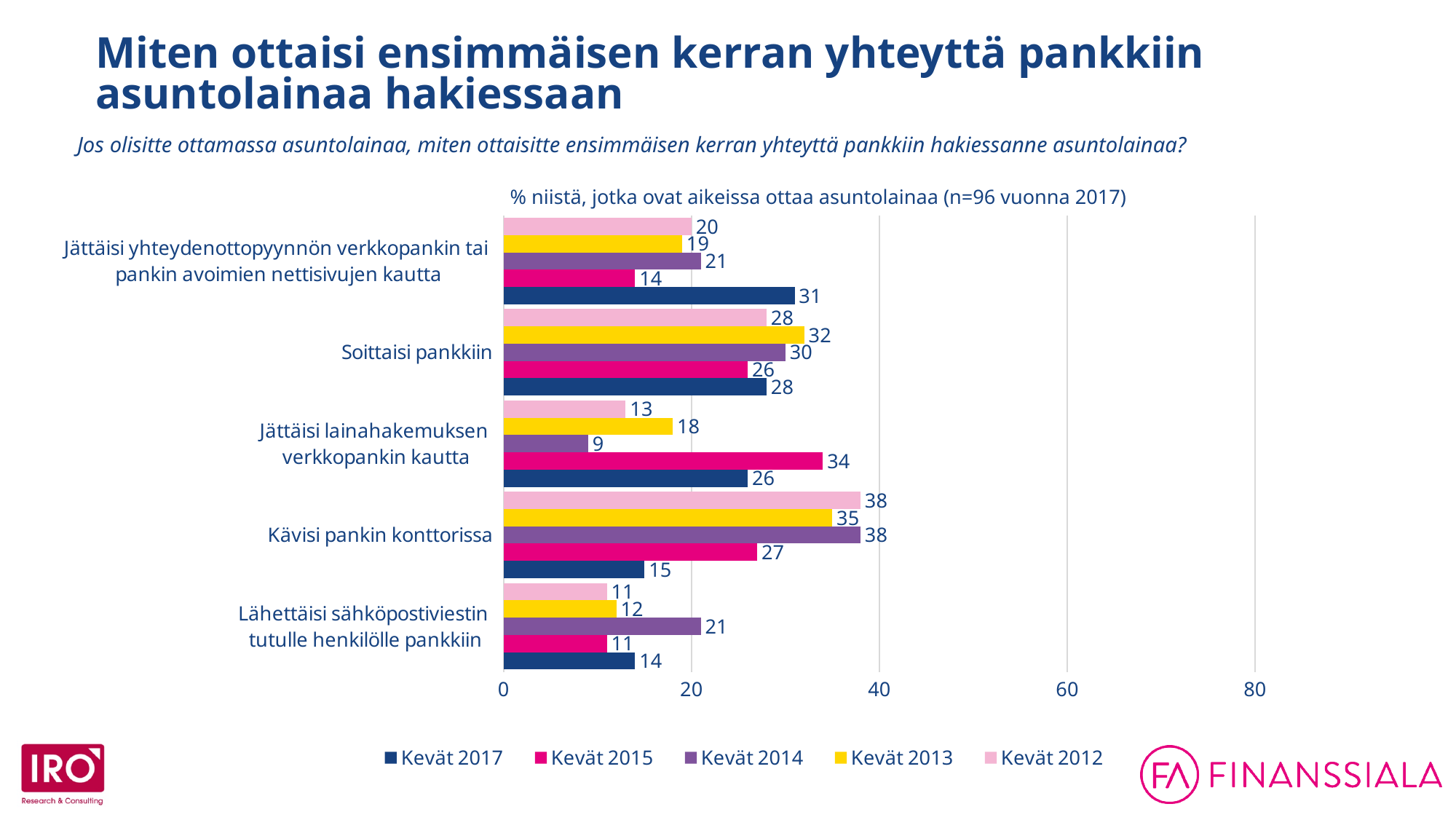
Which category has the lowest value for Kevät 2014? Jättäisi lainahakemuksen verkkopankin kautta Which category has the highest value for Kevät 2017? Jättäisi yhteydenottopyynnön verkkopankin tai pankin avoimien nettisivujen kautta What is the difference between the Kevät 2012 and Kevät 2017 values for 'Kävisi pankin konttorissa'? 23 How many series does the legend list? 5 Which series is shown in dark blue in the legend? Kevät 2017 Which is larger in the category 'Lähettäisi sähköpostiviestin tutulle henkilölle pankkiin': the Kevät 2014 value or the Kevät 2017 value? Kevät 2014 What is the value for Kevät 2013 in the category 'Soittaisi pankkiin'? 32 What is the value for Kevät 2015 in the category 'Jättäisi lainahakemuksen verkkopankin kautta'? 34 What kind of chart is shown on the slide? bar chart What is the value for Kevät 2017 in the category 'Kävisi pankin konttorissa'? 15 Is the value for Kevät 2015 in 'Jättäisi yhteydenottopyynnön verkkopankin tai pankin avoimien nettisivujen kautta' greater or less than 20? less How many categories are shown on the chart? 5